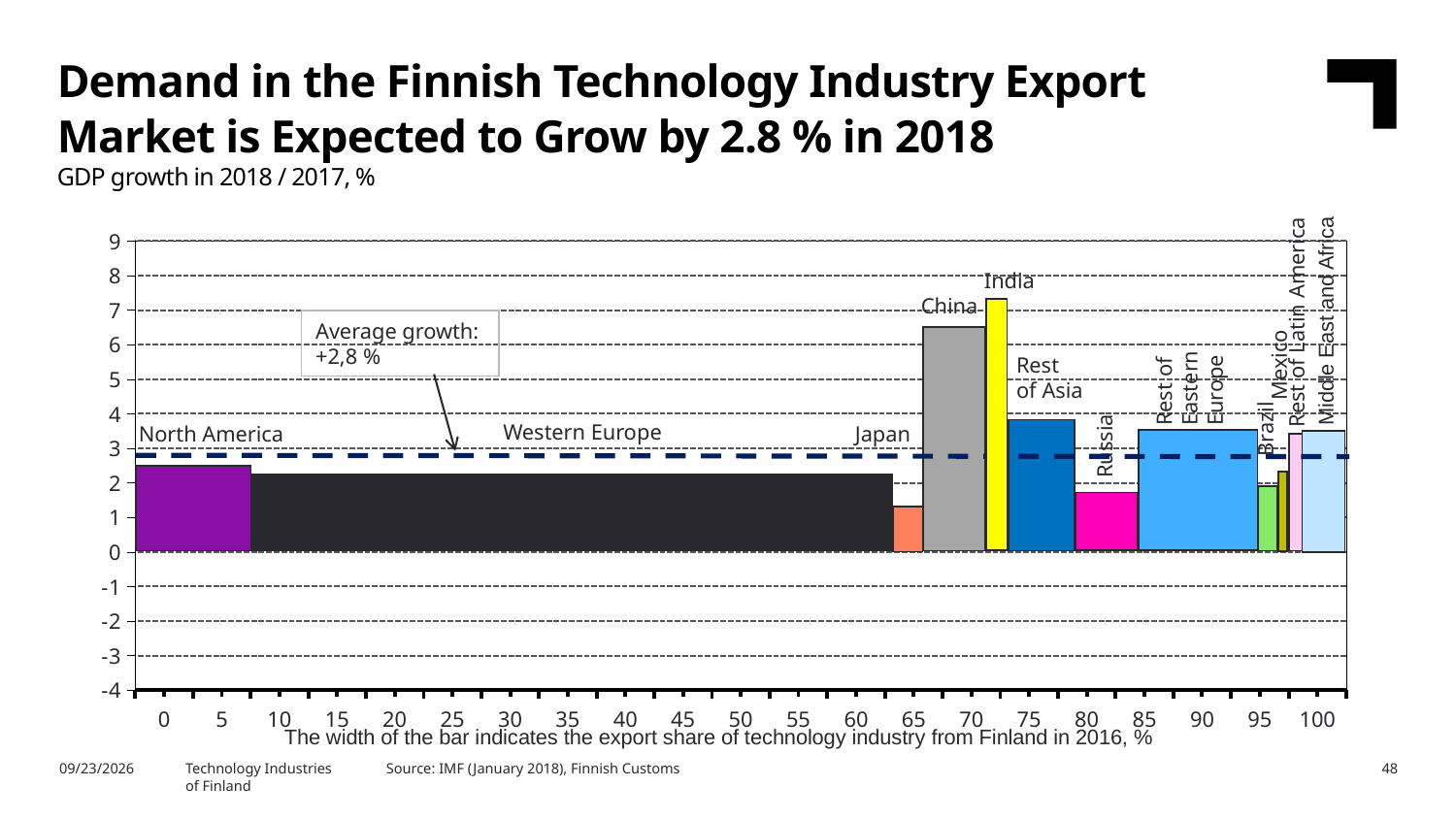
What kind of chart is shown on the slide? bar chart What average growth value is printed in the chart's annotation box? +2,8 % Is the GDP growth value for North America greater or less than 3? less Is the GDP growth value for Rest of Asia greater or less than 3? greater Which has the higher GDP growth, North America or Japan? North America Which region has the highest GDP growth in the chart? India According to the note below the chart, what does the width of each bar indicate? The export share of technology industry from Finland in 2016, % Is the GDP growth value for Japan greater or less than 2? less Which has the higher GDP growth, China or Rest of Asia? China How many regions (bars) are shown in the chart? 12 Which region has the lowest GDP growth in the chart? Japan